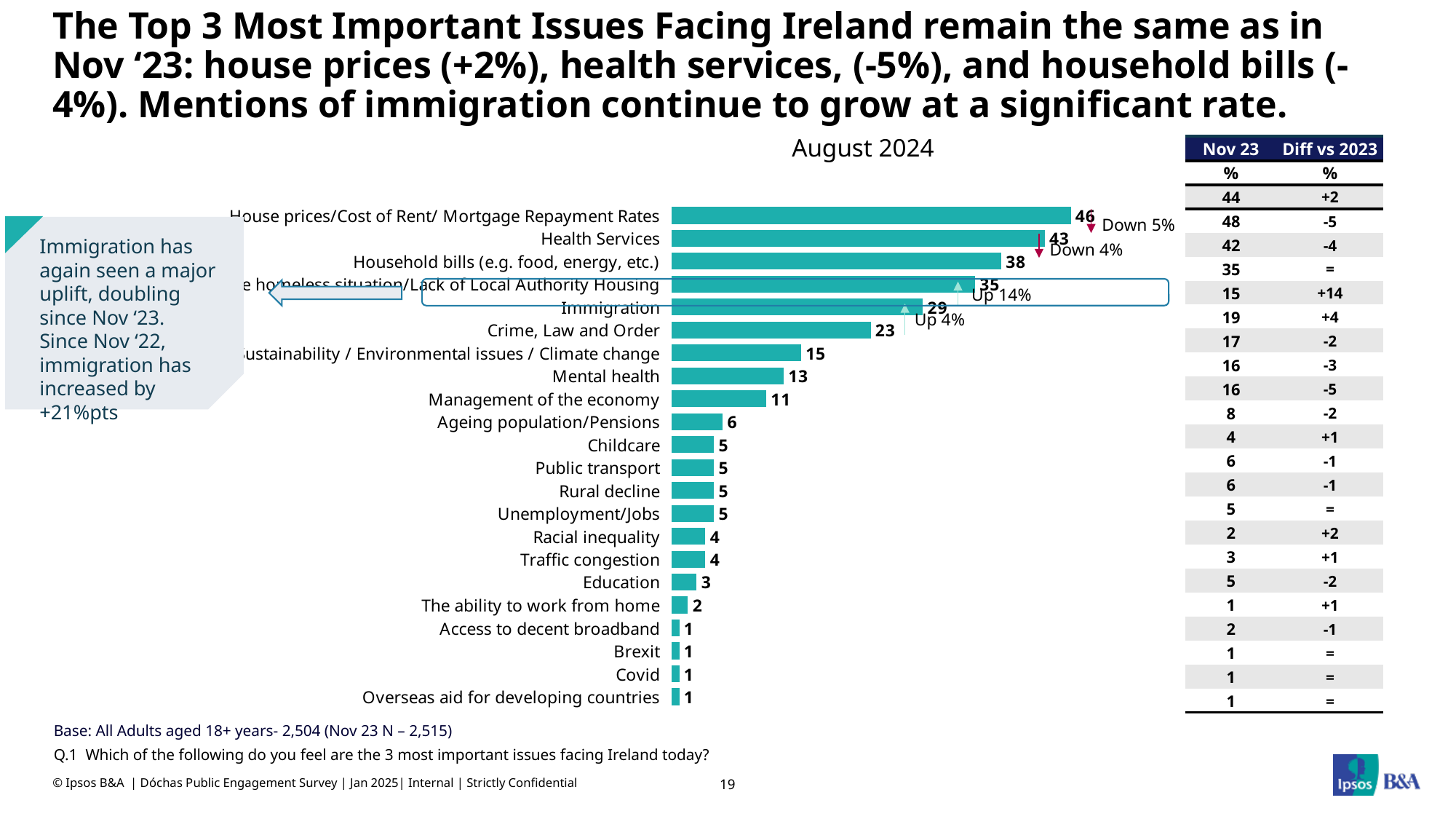
What is the difference between the values for Immigration and Management of the economy in the August 2024 chart? 18 Which category has the highest value in the August 2024 chart? House prices/Cost of Rent/ Mortgage Repayment Rates What is the value for Mental health in the August 2024 chart? 13 How many categories are shown in the August 2024 chart? 22 What is the value for Education in the August 2024 chart? 3 What is the lowest value shown in the August 2024 chart? 1 What kind of chart is shown on the slide? Bar chart Which has a larger value in the August 2024 chart, Ageing population/Pensions or Racial inequality? Ageing population/Pensions What is the title of the chart on the slide? August 2024 What is the value for Immigration in the August 2024 chart? 29 What is the value for Health Services in the August 2024 chart? 43 What is the difference between the values for Household bills (e.g. food, energy, etc.) and Crime, Law and Order in the August 2024 chart? 15